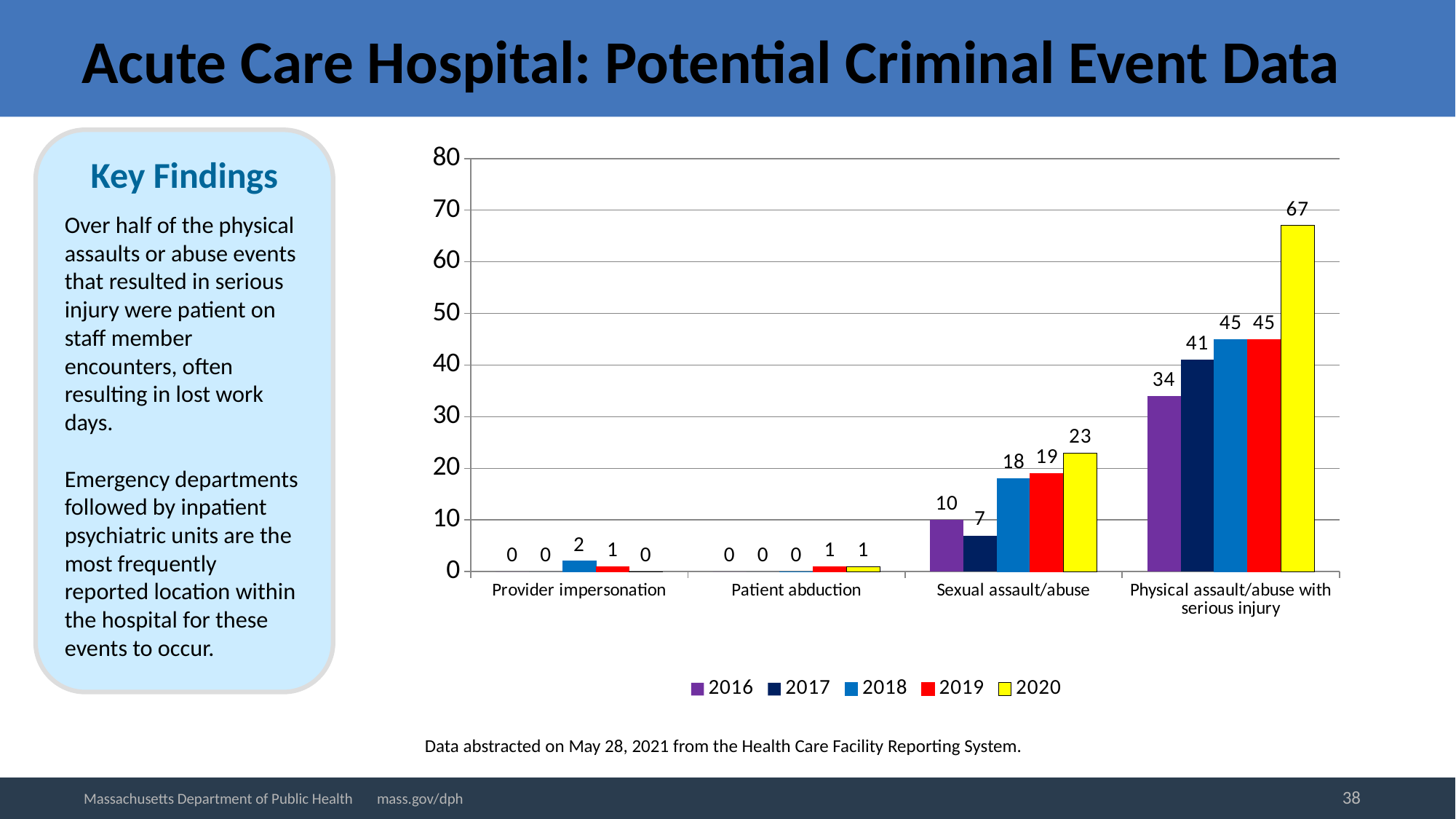
What is the value for 2018 in the Provider impersonation category? 2 How many series does the legend list? 5 Which year has the lowest value in the Sexual assault/abuse category? 2017 How many categories are shown on the x axis? 4 What is the value for 2019 in the Patient abduction category? 1 Which year has the highest value in the Physical assault/abuse with serious injury category? 2020 Which colour represents 2020 in the legend? Yellow What is the difference between the 2020 and 2019 values for Physical assault/abuse with serious injury? 22 What is the value for 2020 in the Physical assault/abuse with serious injury category? 67 Which is larger in the Sexual assault/abuse category: the 2018 value or the 2019 value? 2019 What is the value for 2016 in the Sexual assault/abuse category? 10 What kind of chart is shown on the slide? Bar chart